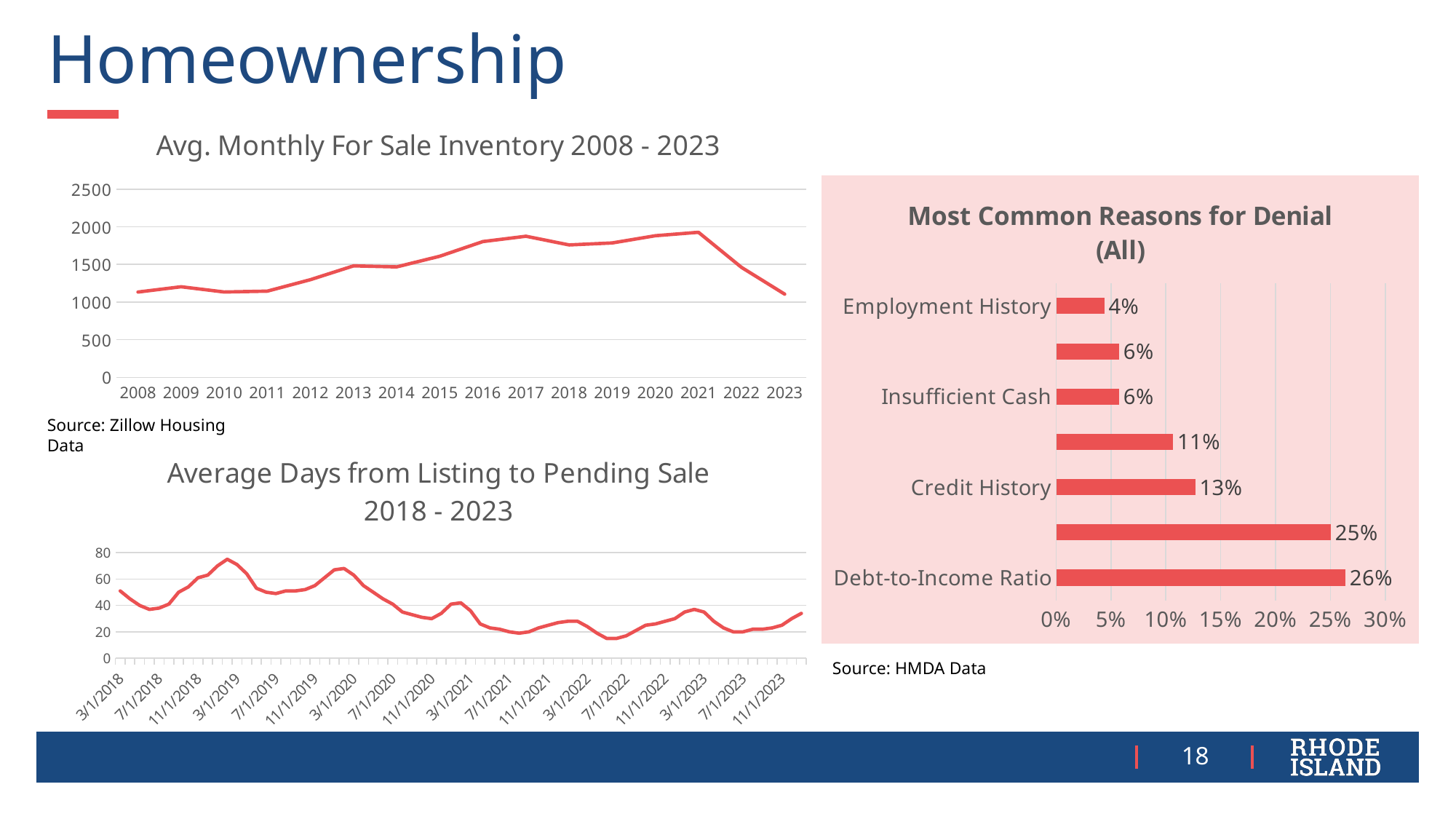
In the 'Most Common Reasons for Denial (All)' chart, what is the value for Employment History? 4% In the 'Most Common Reasons for Denial (All)' chart, what is the difference between Credit History and Employment History? 9 percentage points In the 'Most Common Reasons for Denial (All)' chart, which labeled category has the highest value? Debt-to-Income Ratio In the 'Avg. Monthly For Sale Inventory 2008 - 2023' chart, is the value for 2023 greater or less than 1500? less In the 'Most Common Reasons for Denial (All)' chart, what is the value for Insufficient Cash? 6% In the 'Most Common Reasons for Denial (All)' chart, which labeled category has the lowest value? Employment History In the 'Avg. Monthly For Sale Inventory 2008 - 2023' chart, is the value for 2021 greater or less than 1500? greater In the 'Most Common Reasons for Denial (All)' chart, what is the value for Debt-to-Income Ratio? 26% How many bars are shown in the 'Most Common Reasons for Denial (All)' chart? 7 In the 'Avg. Monthly For Sale Inventory 2008 - 2023' chart, do values rise or fall from 2021 to 2023? fall What kind of chart is 'Most Common Reasons for Denial (All)'? Bar chart In the 'Most Common Reasons for Denial (All)' chart, what is the value for Credit History? 13%